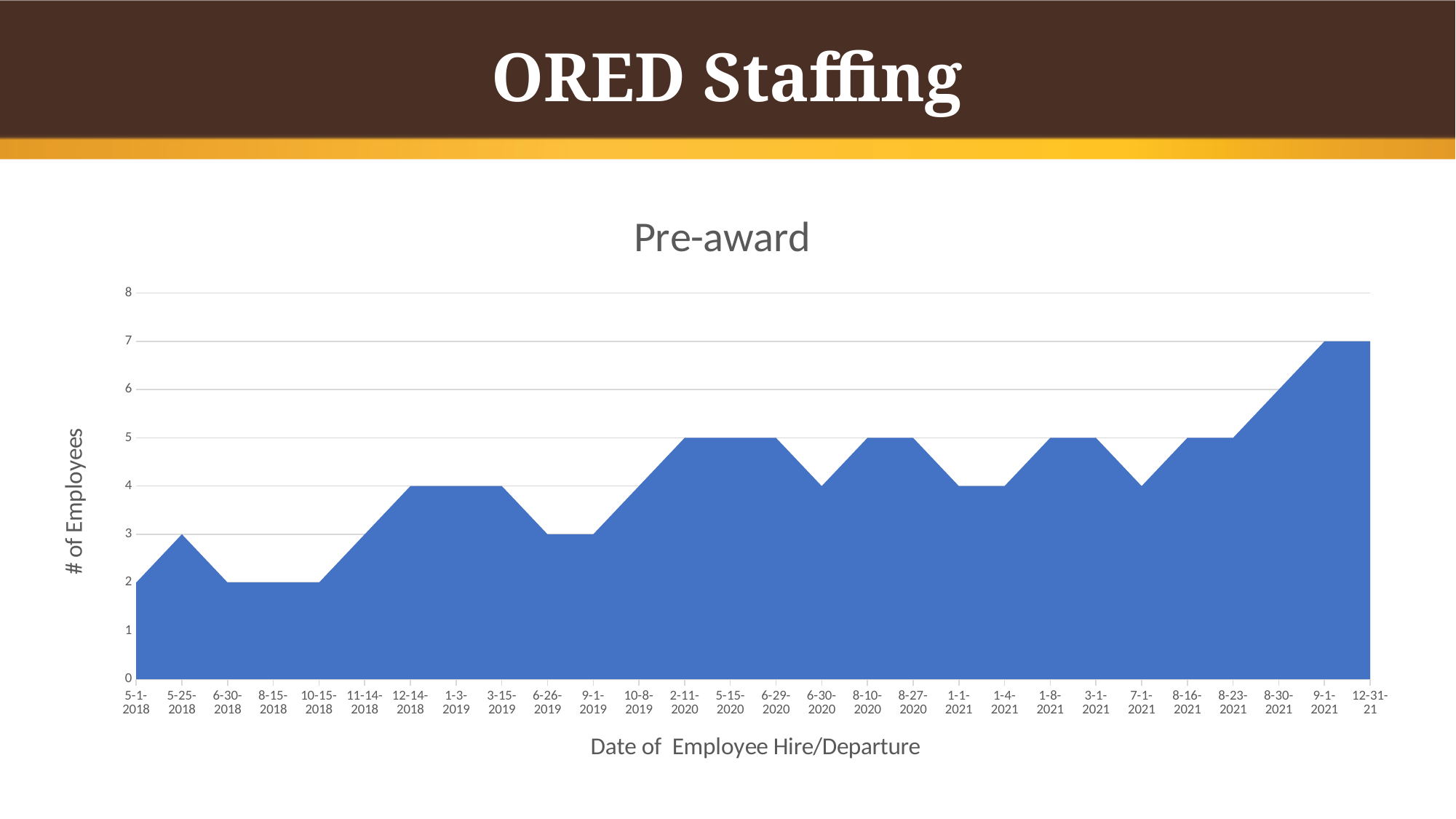
Which date has more employees, 6-30-2020 or 8-10-2020? 8-10-2020 What is the title of the chart? Pre-award What is the number of employees on 5-1-2018? 2 What type of chart is shown on the slide? Area chart What is the number of employees on 2-11-2020? 5 What is the difference in the number of employees between 12-31-21 and 5-1-2018? 5 What is the y-axis label of the chart? # of Employees What is the number of employees on 12-14-2018? 4 What is the highest number of employees reached in the chart? 7 Overall, does the number of employees rise or fall from 5-1-2018 to 12-31-21? Rise What is the lowest number of employees shown in the chart? 2 What is the number of employees on 12-31-21? 7